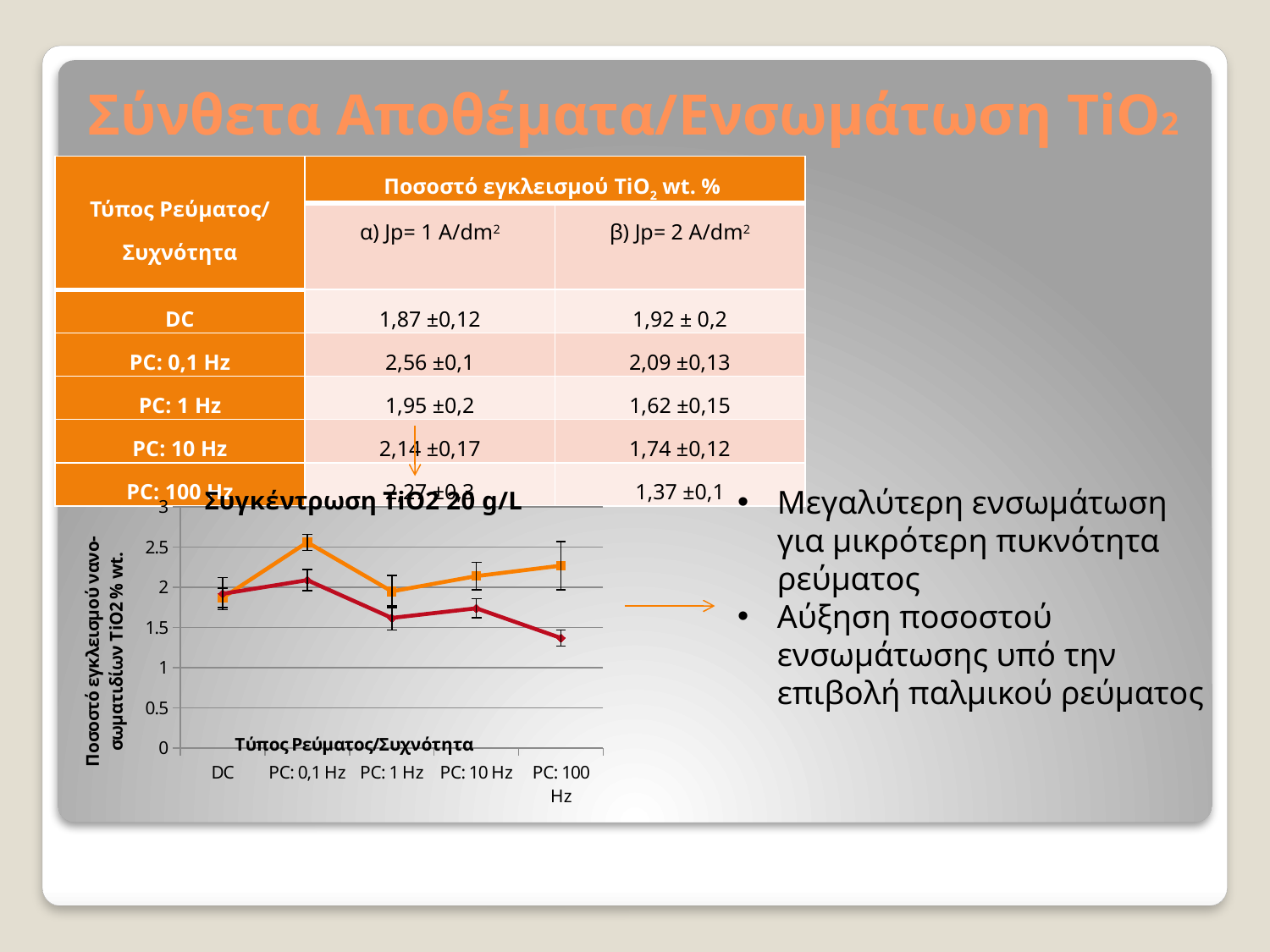
Is the value of the red line at PC: 100 Hz greater or less than 1.5? less Is the value of the red line at PC: 1 Hz greater or less than 2? less How many categories are shown on the x axis of the chart? 5 At PC: 100 Hz, which line has the larger value, the orange line or the red line? orange line What kind of chart is shown on the slide? line chart What is the title of the chart? Συγκέντρωση TiO2 20 g/L For which category does the red line reach its lowest value? PC: 100 Hz For which category does the orange line reach its highest value? PC: 0,1 Hz What is the highest tick value shown on the y axis of the chart? 3 Does the red line rise or fall from PC: 10 Hz to PC: 100 Hz? fall Is the value of the orange line at PC: 100 Hz greater or less than 2? greater How many lines (series) are plotted in the chart? 2